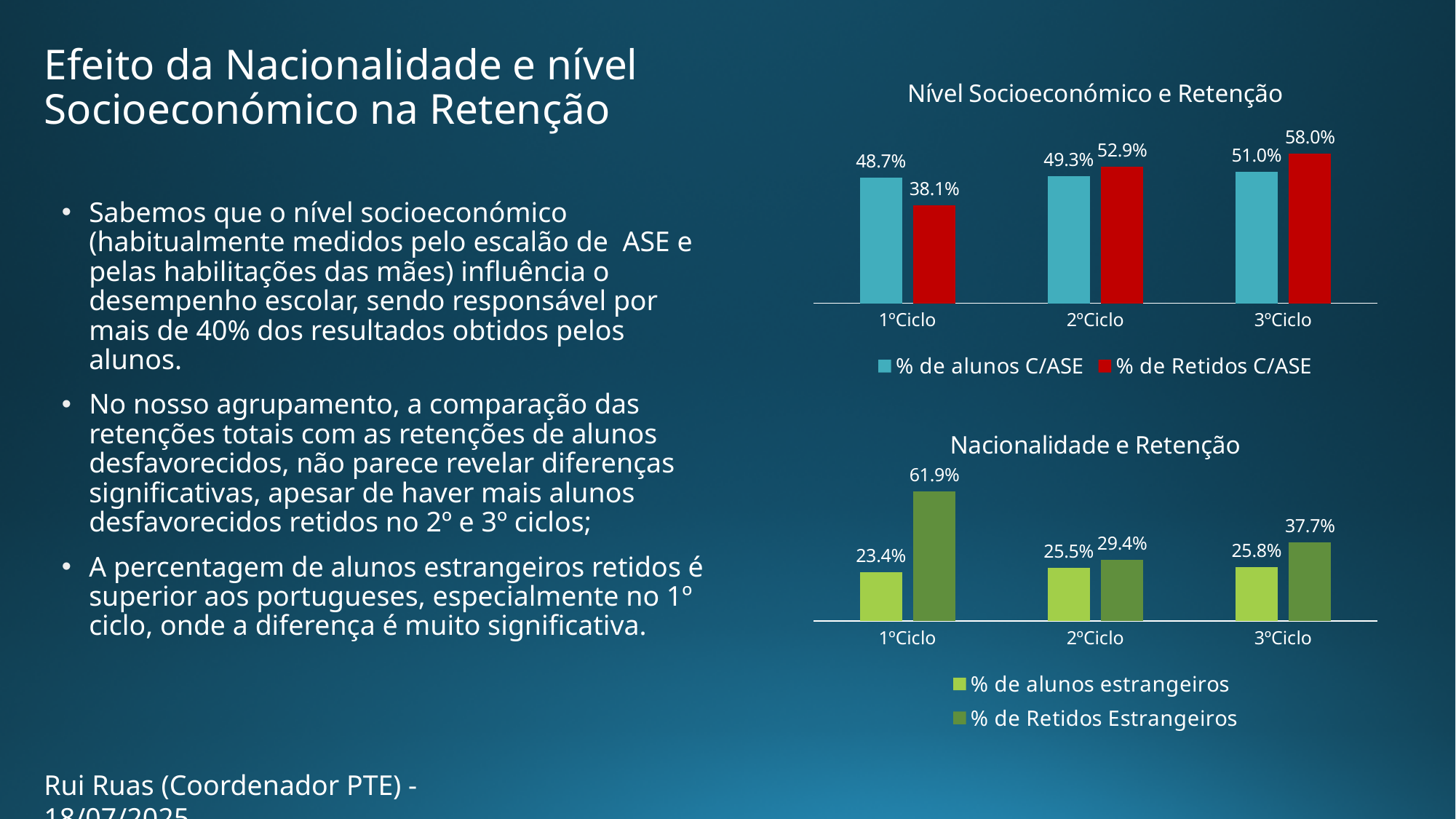
In the 'Nível Socioeconómico e Retenção' chart, what is the value of '% de alunos C/ASE' for 3ºCiclo? 51.0% In the 'Nacionalidade e Retenção' chart, what is the difference between '% de Retidos Estrangeiros' and '% de alunos estrangeiros' for 1ºCiclo? 38.5% In the 'Nacionalidade e Retenção' chart, what is the value of '% de alunos estrangeiros' for 2ºCiclo? 25.5% What type of chart is the 'Nível Socioeconómico e Retenção' chart? bar chart In the 'Nível Socioeconómico e Retenção' chart, do the values of '% de Retidos C/ASE' rise or fall from 1ºCiclo to 3ºCiclo? rise In the 'Nacionalidade e Retenção' chart, which ciclo has the lowest value for '% de Retidos Estrangeiros'? 2ºCiclo How many series does the legend of the 'Nacionalidade e Retenção' chart list? 2 In the 'Nível Socioeconómico e Retenção' chart, for 1ºCiclo, which is larger: '% de alunos C/ASE' or '% de Retidos C/ASE'? % de alunos C/ASE In the 'Nacionalidade e Retenção' chart, what is the value of '% de Retidos Estrangeiros' for 1ºCiclo? 61.9% In the 'Nível Socioeconómico e Retenção' chart, what is the difference between '% de Retidos C/ASE' and '% de alunos C/ASE' for 3ºCiclo? 7.0% In the 'Nível Socioeconómico e Retenção' chart, what is the value of '% de Retidos C/ASE' for 1ºCiclo? 38.1% In the 'Nível Socioeconómico e Retenção' chart, which ciclo has the highest value for '% de Retidos C/ASE'? 3ºCiclo